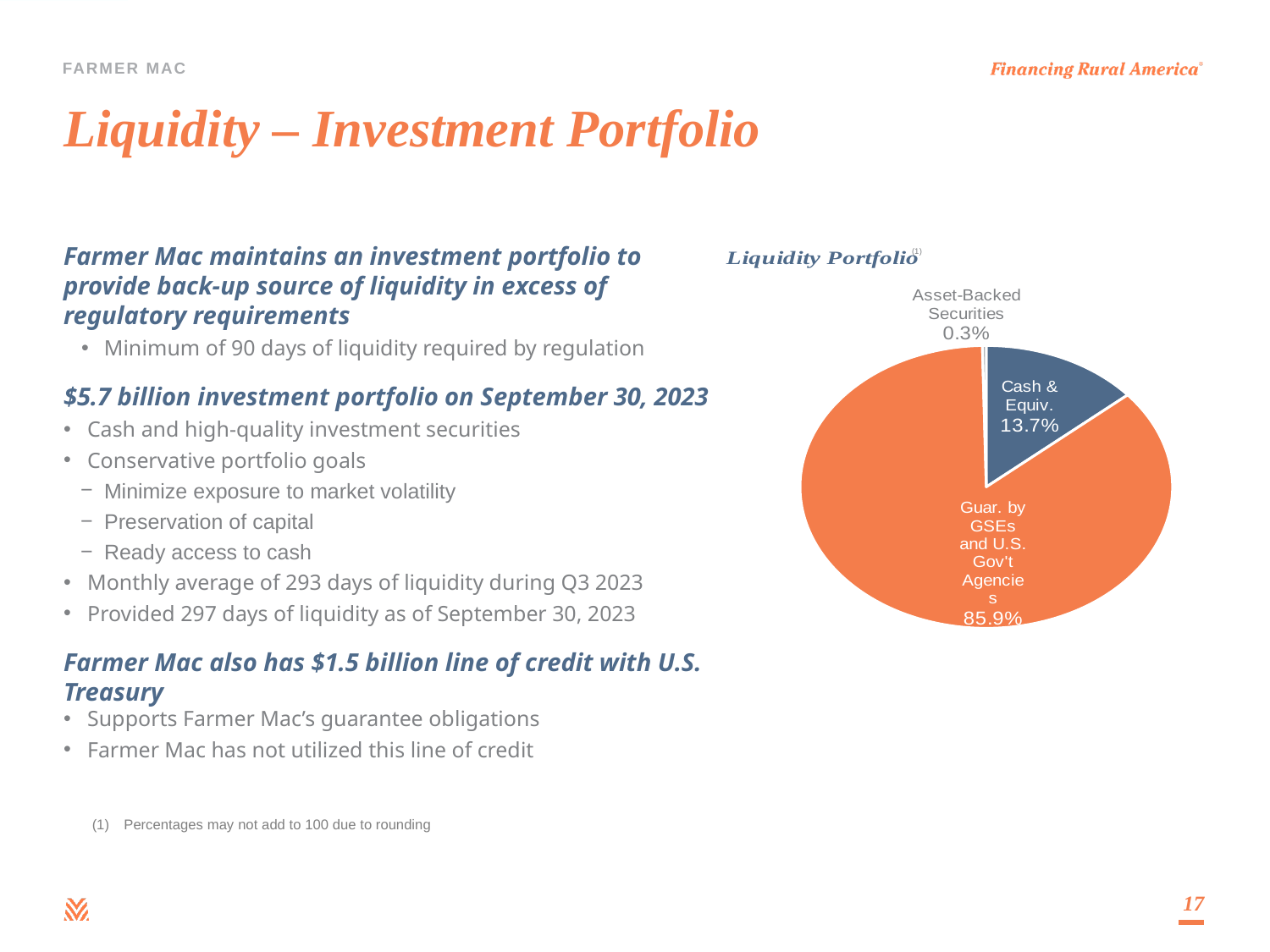
What share of the Liquidity Portfolio is Guar. by GSEs and U.S. Gov't Agencies? 85.9% How many slices does the Liquidity Portfolio pie chart have? 3 In the Liquidity Portfolio chart, which is larger: Cash & Equiv. or Asset-Backed Securities? Cash & Equiv. Which slice of the Liquidity Portfolio pie is the largest? Guar. by GSEs and U.S. Gov't Agencies What share of the Liquidity Portfolio is Asset-Backed Securities? 0.3% What is the title of the pie chart on the slide? Liquidity Portfolio In the Liquidity Portfolio chart, what is the combined share of Cash & Equiv. and Asset-Backed Securities? 14.0% What share of the Liquidity Portfolio is Cash & Equiv.? 13.7% What kind of chart is the Liquidity Portfolio chart? pie chart In the Liquidity Portfolio chart, what is the difference in percentage points between Guar. by GSEs and U.S. Gov't Agencies and Cash & Equiv.? 72.2 percentage points Which slice of the Liquidity Portfolio pie is the smallest? Asset-Backed Securities What colour is the Cash & Equiv. slice in the Liquidity Portfolio chart? blue